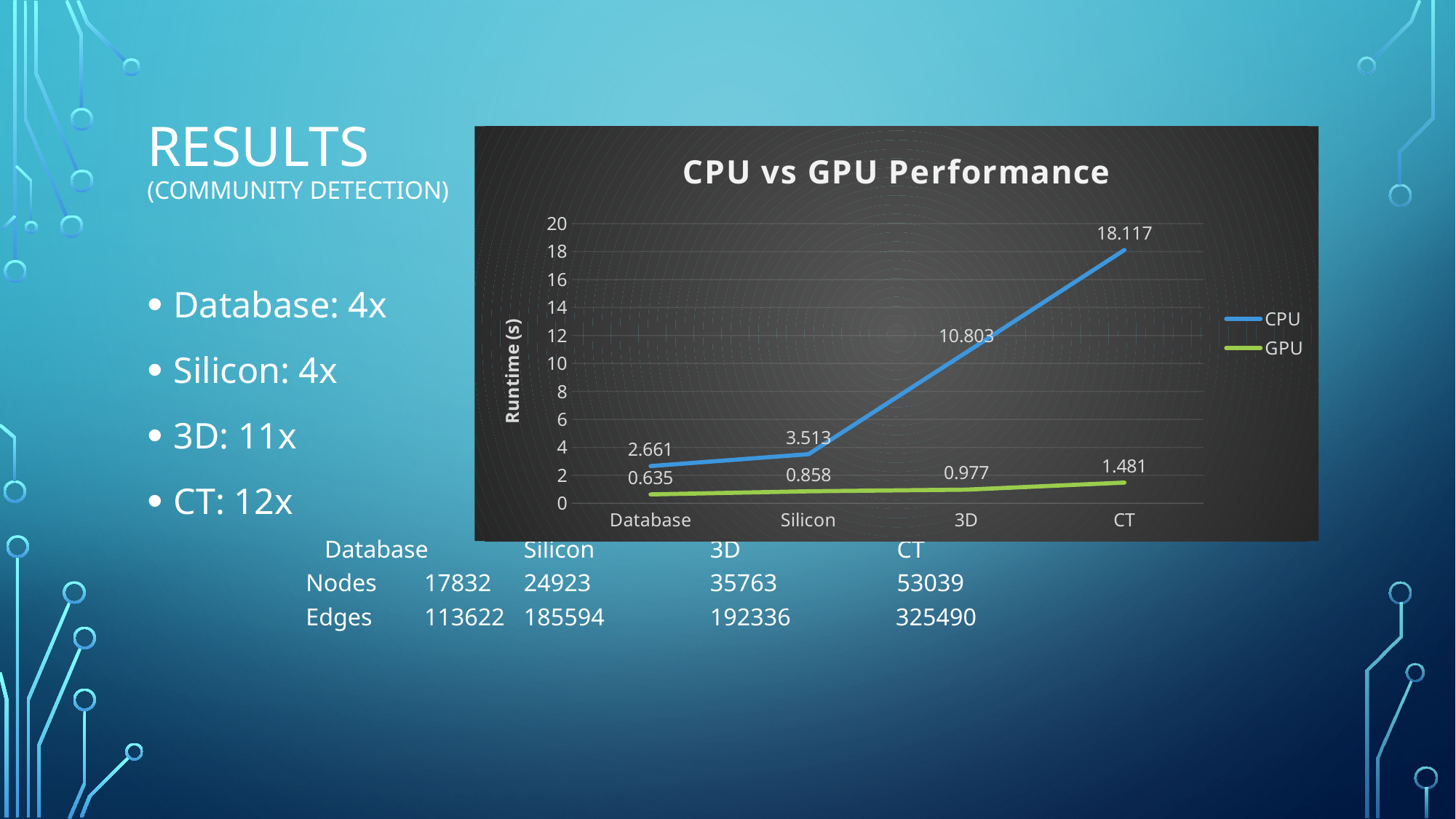
Which dataset has the lowest GPU runtime? Database How many datasets are shown on the x axis? 4 What is the CPU runtime for Silicon? 3.513 What is the difference between the CPU and GPU runtimes for 3D? 9.826 What kind of chart is shown? Line chart What is the GPU runtime for the Database dataset? 0.635 Which is larger, the CPU runtime for Database or the CPU runtime for Silicon? Silicon Which dataset has the highest CPU runtime? CT What is the GPU runtime for 3D? 0.977 Does the CPU runtime rise or fall from Database to CT? Rise How many series does the legend list? 2 What is the CPU runtime for the CT dataset? 18.117